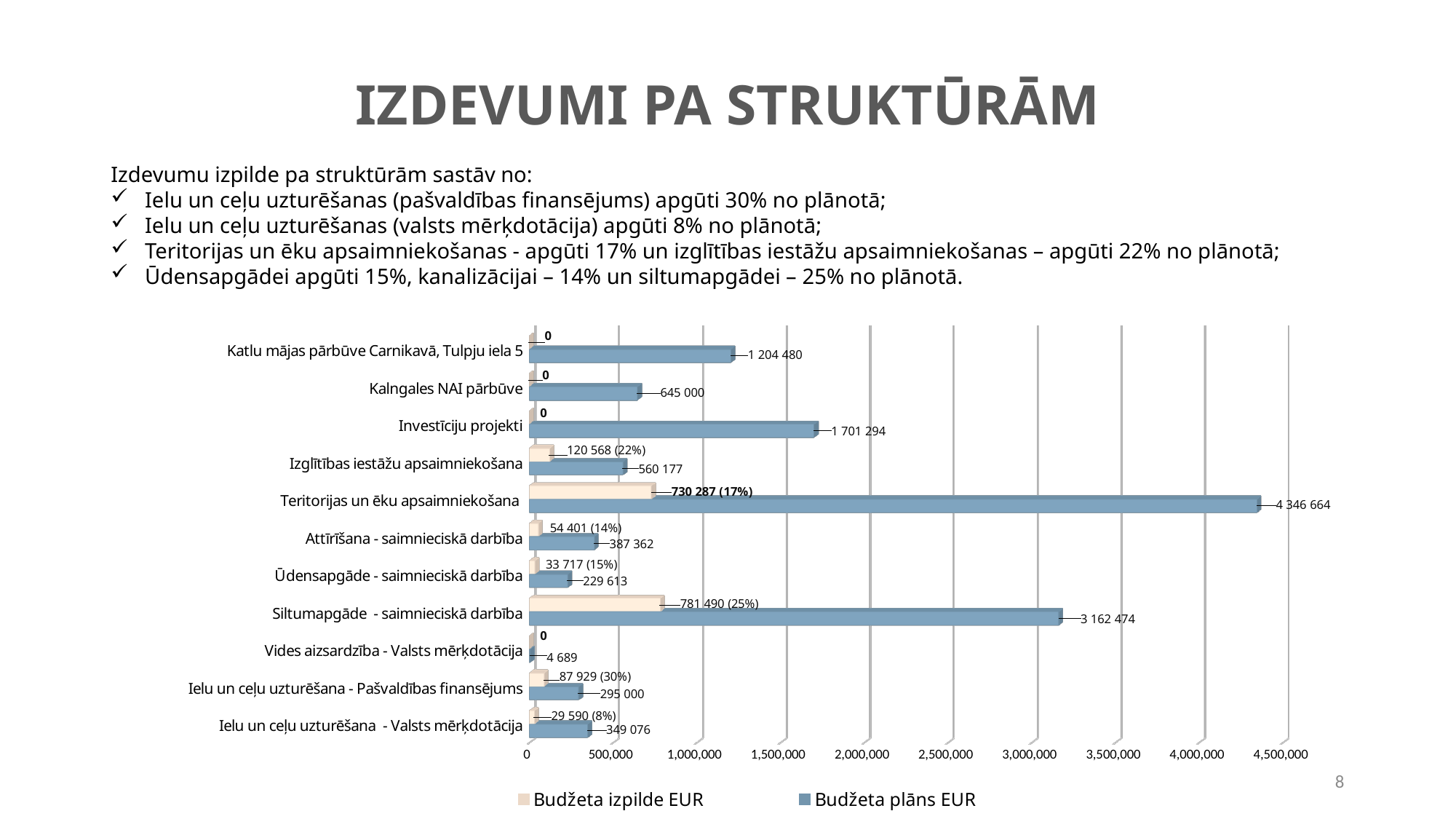
How many series does the legend list? 2 What type of chart is shown on the slide? Bar chart Is the Budžeta plāns EUR value for Siltumapgāde - saimnieciskā darbība greater or less than 3,000,000? greater What is the Budžeta plāns EUR value for Kalngales NAI pārbūve? 645 000 What is the difference between the Budžeta plāns EUR and Budžeta izpilde EUR values for Siltumapgāde - saimnieciskā darbība? 2 380 984 What is the Budžeta plāns EUR value for Teritorijas un ēku apsaimniekošana? 4 346 664 How many categories are plotted on the chart? 11 Which series is shown in blue in the legend? Budžeta plāns EUR What is the Budžeta izpilde EUR value for Siltumapgāde - saimnieciskā darbība? 781 490 (25%) Which is larger: the Budžeta plāns EUR value for Investīciju projekti or for Katlu mājas pārbūve Carnikavā, Tulpju iela 5? Investīciju projekti Which category has the lowest Budžeta plāns EUR value? Vides aizsardzība - Valsts mērķdotācija Which category has the highest Budžeta plāns EUR value? Teritorijas un ēku apsaimniekošana